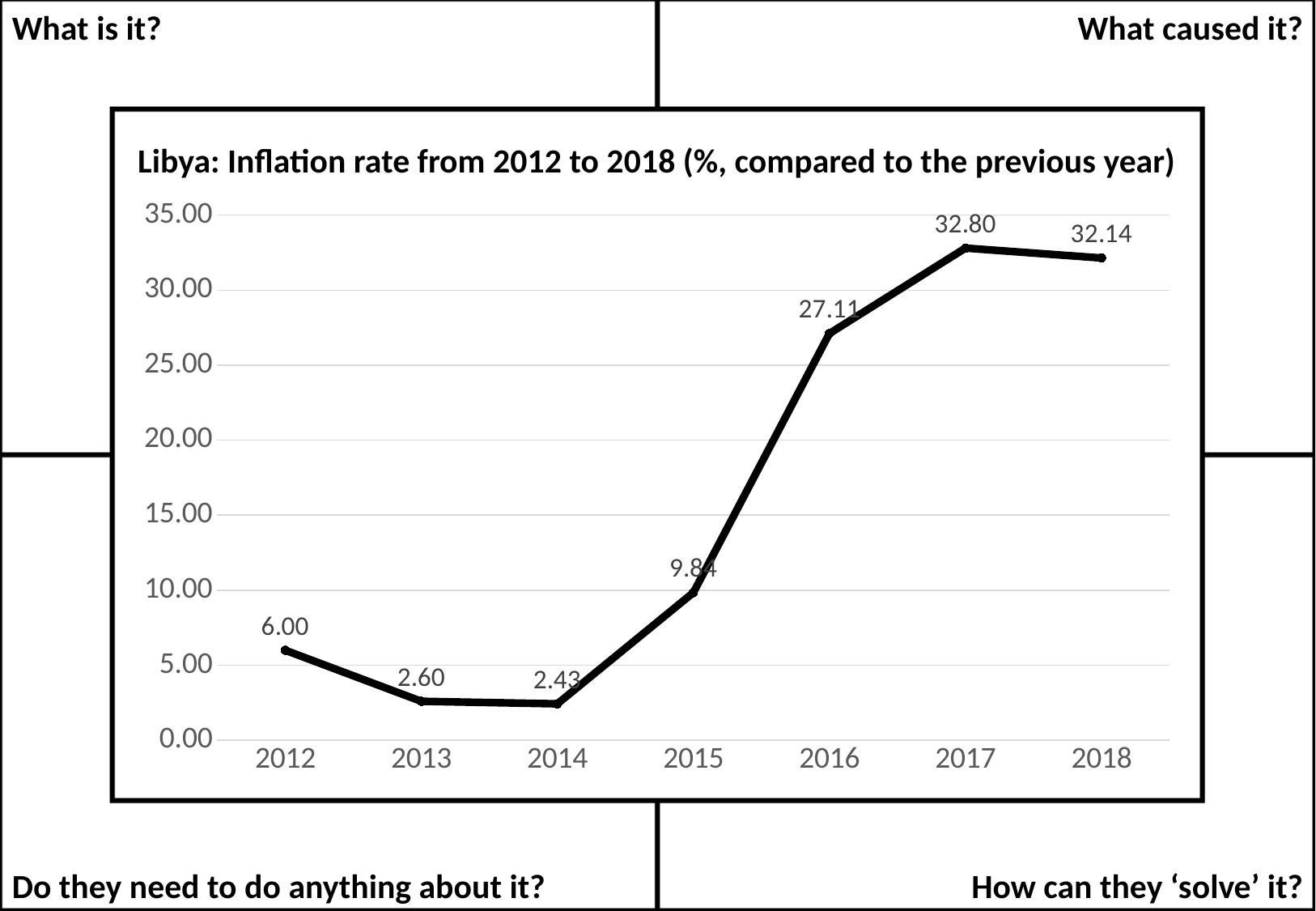
What is the difference between the inflation rate in 2015 and in 2012? 3.84 What was Libya's inflation rate in 2018? 32.14 What was Libya's inflation rate in 2016? 27.11 Which year had a higher inflation rate, 2012 or 2015? 2015 How many years are plotted on the chart? 7 Which year had the highest inflation rate? 2017 What kind of chart is shown on the slide? line chart Is the inflation rate for 2016 greater or less than 25.00? greater What is the difference between the inflation rate in 2017 and in 2016? 5.69 Which year had the lowest inflation rate? 2014 Did the inflation rate rise or fall between 2014 and 2017? rise What was Libya's inflation rate in 2013? 2.60